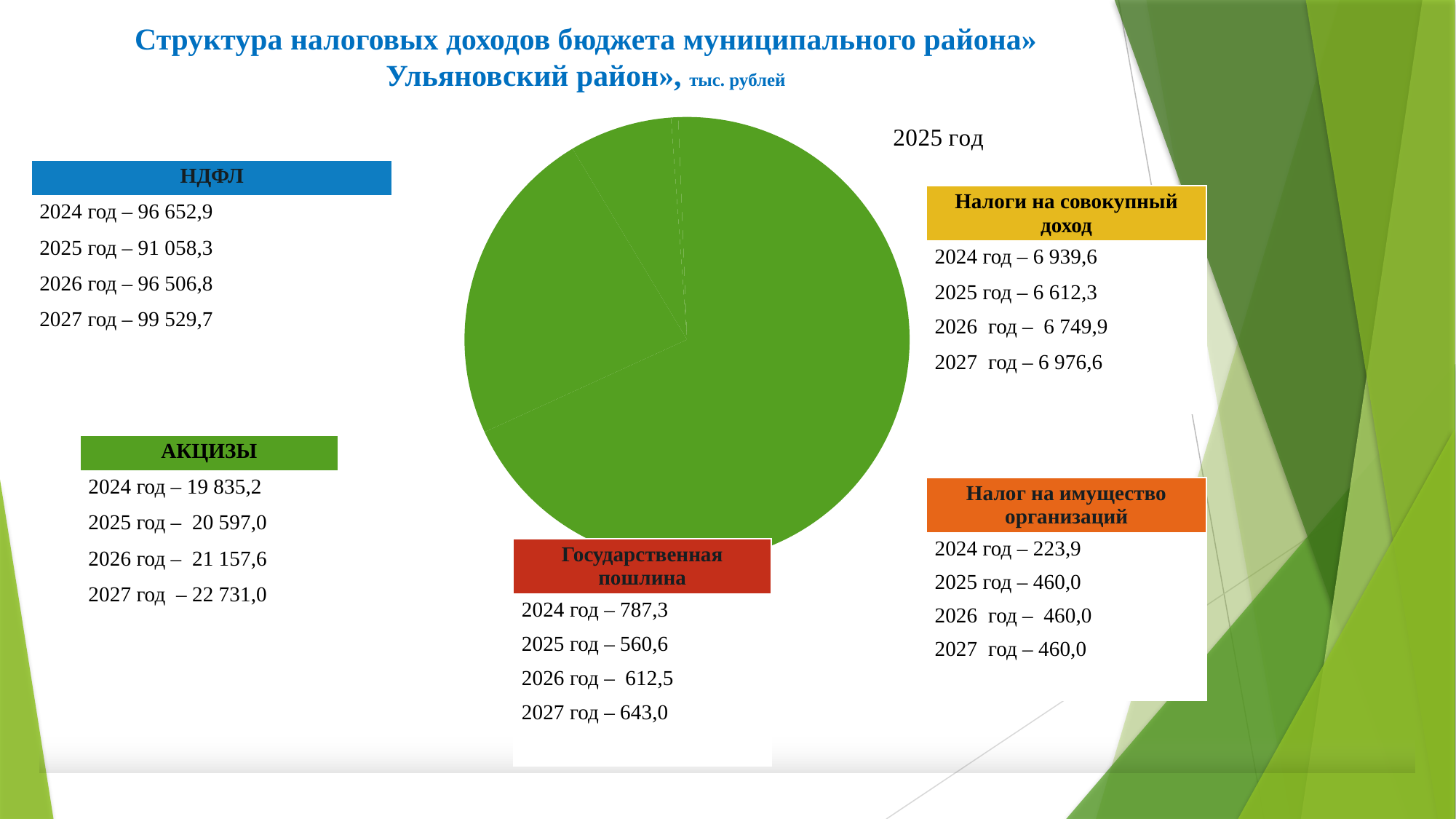
Which is larger in 2025, Акцизы or Налоги на совокупный доход? Акцизы What is the value for Акцизы in 2025? 20 597,0 How many tax categories make up the pie chart? 5 What is the total of all five categories shown in the pie chart for 2025? 119 288,2 What kind of chart is shown on the slide? pie chart Which category is the largest slice of the pie chart? НДФЛ What is the value for Государственная пошлина in 2025? 560,6 Which year does the pie chart represent? 2025 год What is the difference between НДФЛ and Акцизы in 2025? 70 461,3 What is the value for Налоги на совокупный доход in 2025? 6 612,3 What is the value for НДФЛ in 2025? 91 058,3 Which category is the smallest slice of the pie chart? Налог на имущество организаций